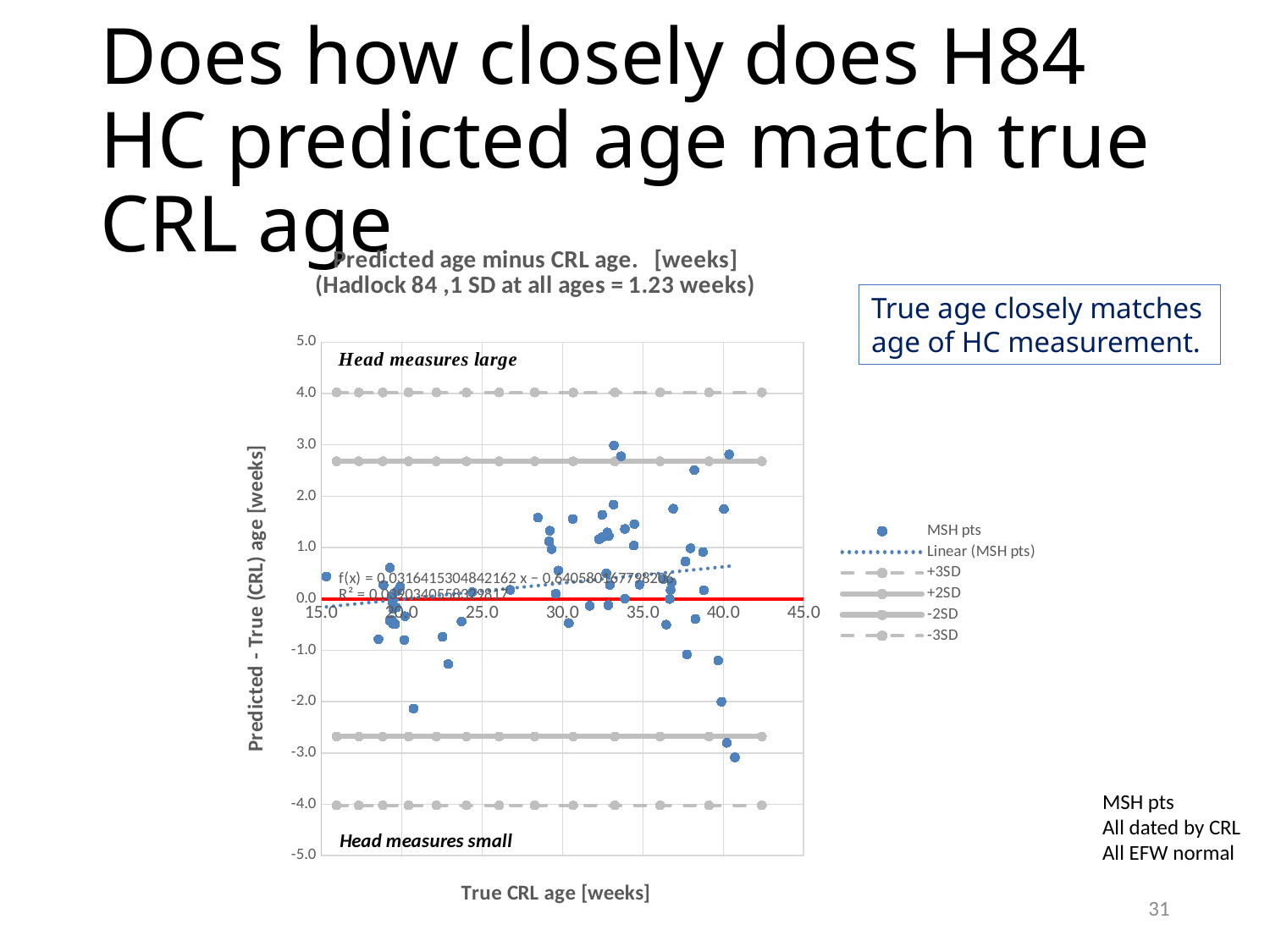
Is the +3SD line greater or less than 3.0 on the y axis? greater What is the label of the x axis? True CRL age [weeks] Is the -3SD line greater or less than -3.0 on the y axis? less Is the +2SD line greater or less than 2.0 on the y axis? greater How many series does the chart legend list? 6 Does the dotted linear trendline for MSH pts rise or fall as true CRL age increases? rise What is the maximum value shown on the y axis? 5.0 Which is higher on the y axis, the +3SD line or the +2SD line? +3SD What is the name of the series plotted as blue dots? MSH pts What is the title of the chart? Predicted age minus CRL age. [weeks] (Hadlock 84 ,1 SD at all ages = 1.23 weeks) What kind of chart is shown on the slide? scatter chart